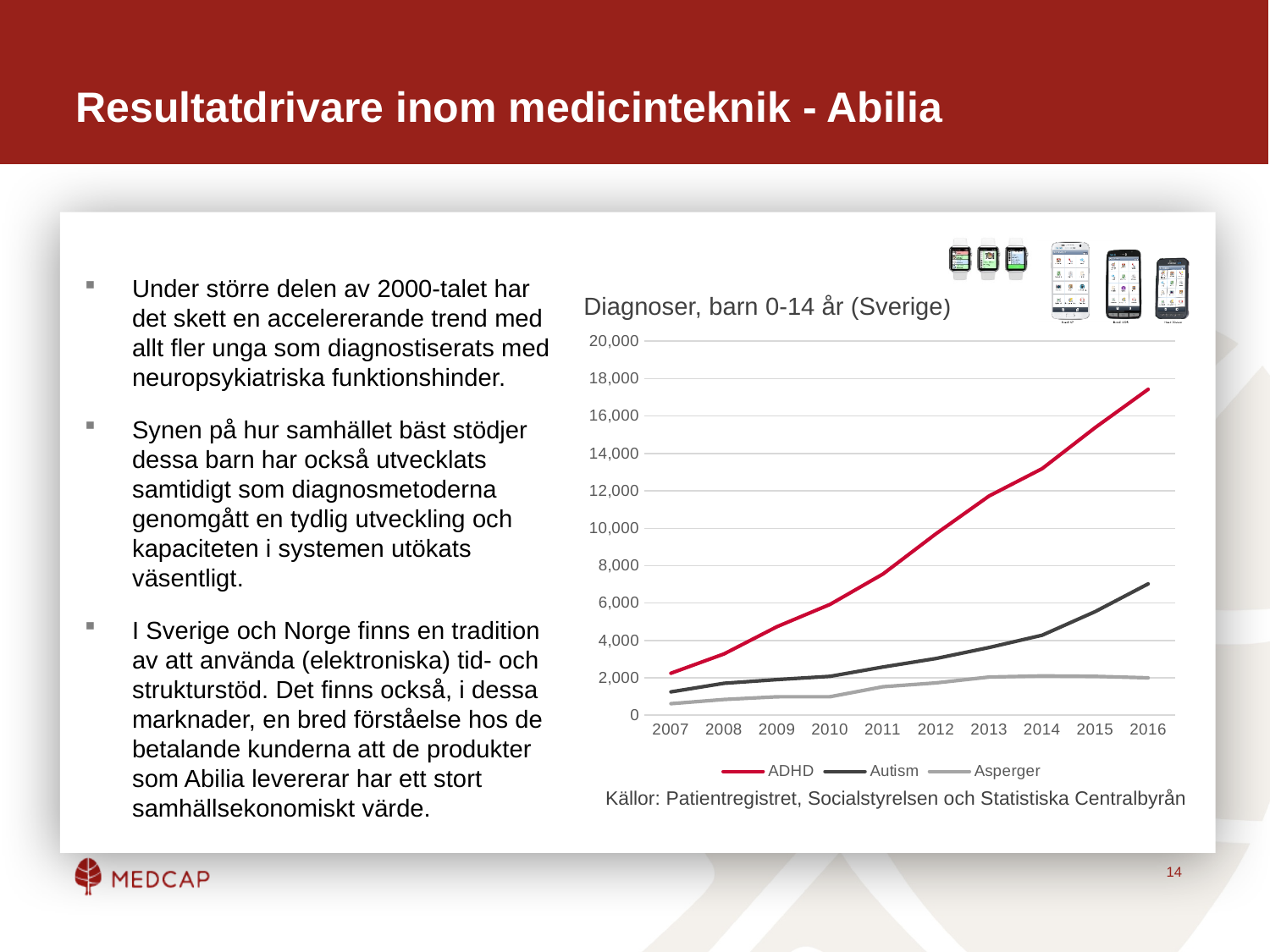
Which series is drawn in red in the chart? ADHD Is the value for Asperger in 2016 greater or less than 4,000? less In 2016, which is larger: the value for ADHD or the value for Autism? ADHD How many series does the legend of the chart list? 3 Is the value for ADHD in 2016 greater or less than 16,000? greater Does the ADHD line rise or fall from 2007 to 2016? rise Which series has the highest value in 2016? ADHD Is the value for Autism in 2016 greater or less than 6,000? greater What is the title of the chart? Diagnoser, barn 0-14 år (Sverige) How many years are shown on the x axis of the chart? 10 Which series has the lowest value in 2016? Asperger What kind of chart is shown on the slide? line chart